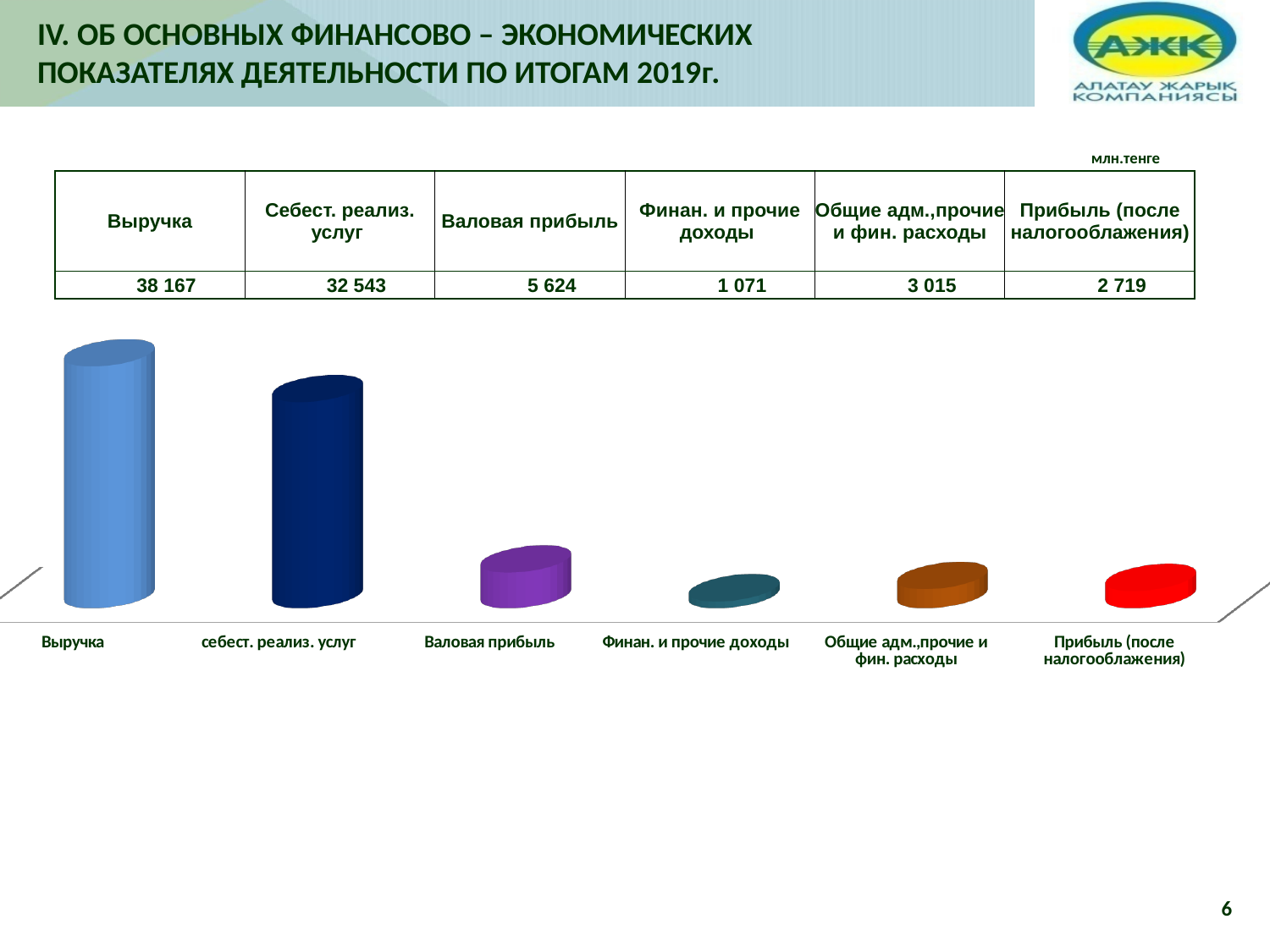
What is the difference between Выручка and Себест. реализ. услуг? 5 624 What is the value for Валовая прибыль? 5 624 In what units are the values on the slide given? млн.тенге Which category has the lowest value in the chart? Финан. и прочие доходы What is the value for Выручка? 38 167 What is the value for Общие адм., прочие и фин. расходы? 3 015 Which is larger, Себест. реализ. услуг or Валовая прибыль? Себест. реализ. услуг What is the value for Прибыль (после налогообложения)? 2 719 Which category has the highest value in the chart? Выручка What kind of chart is shown on the slide? bar chart What is the difference between Общие адм., прочие и фин. расходы and Финан. и прочие доходы? 1 944 How many categories are plotted in the chart? 6